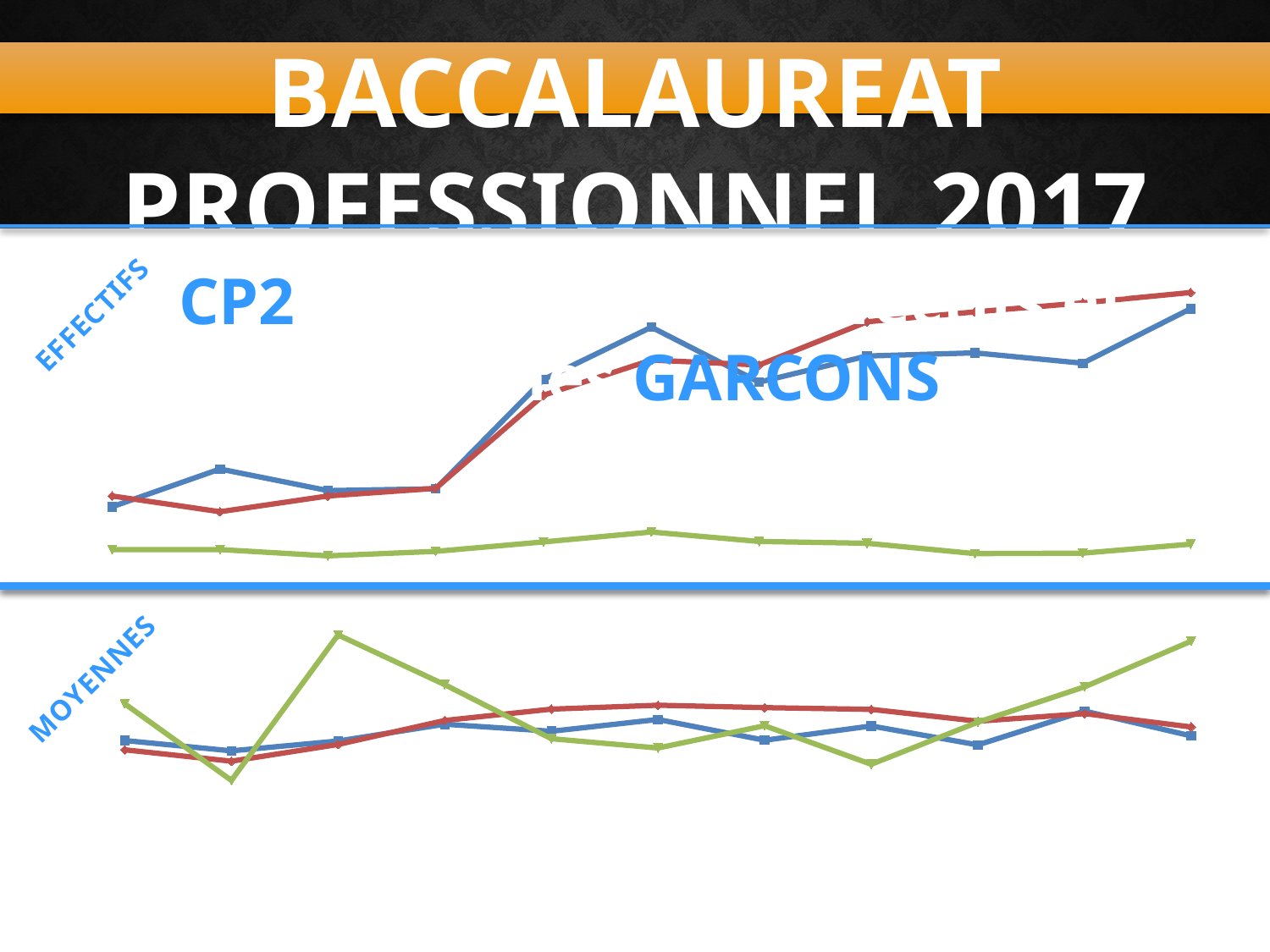
How many data points does each line in the bottom chart labelled MOYENNES have? 11 In the top chart labelled EFFECTIFS, which coloured line stays lowest across the whole chart? the green line How many lines are plotted in the top chart labelled EFFECTIFS? 3 How many lines are plotted in the bottom chart labelled MOYENNES? 3 How many data points does each line in the top chart labelled EFFECTIFS have? 11 What label is written vertically next to the top chart? EFFECTIFS In the top chart labelled EFFECTIFS, does the red line overall rise or fall from left to right? rise What kind of chart is the top chart labelled EFFECTIFS? line chart What kind of chart is the bottom chart labelled MOYENNES? line chart In the top chart labelled EFFECTIFS, does the blue line overall rise or fall from left to right? rise